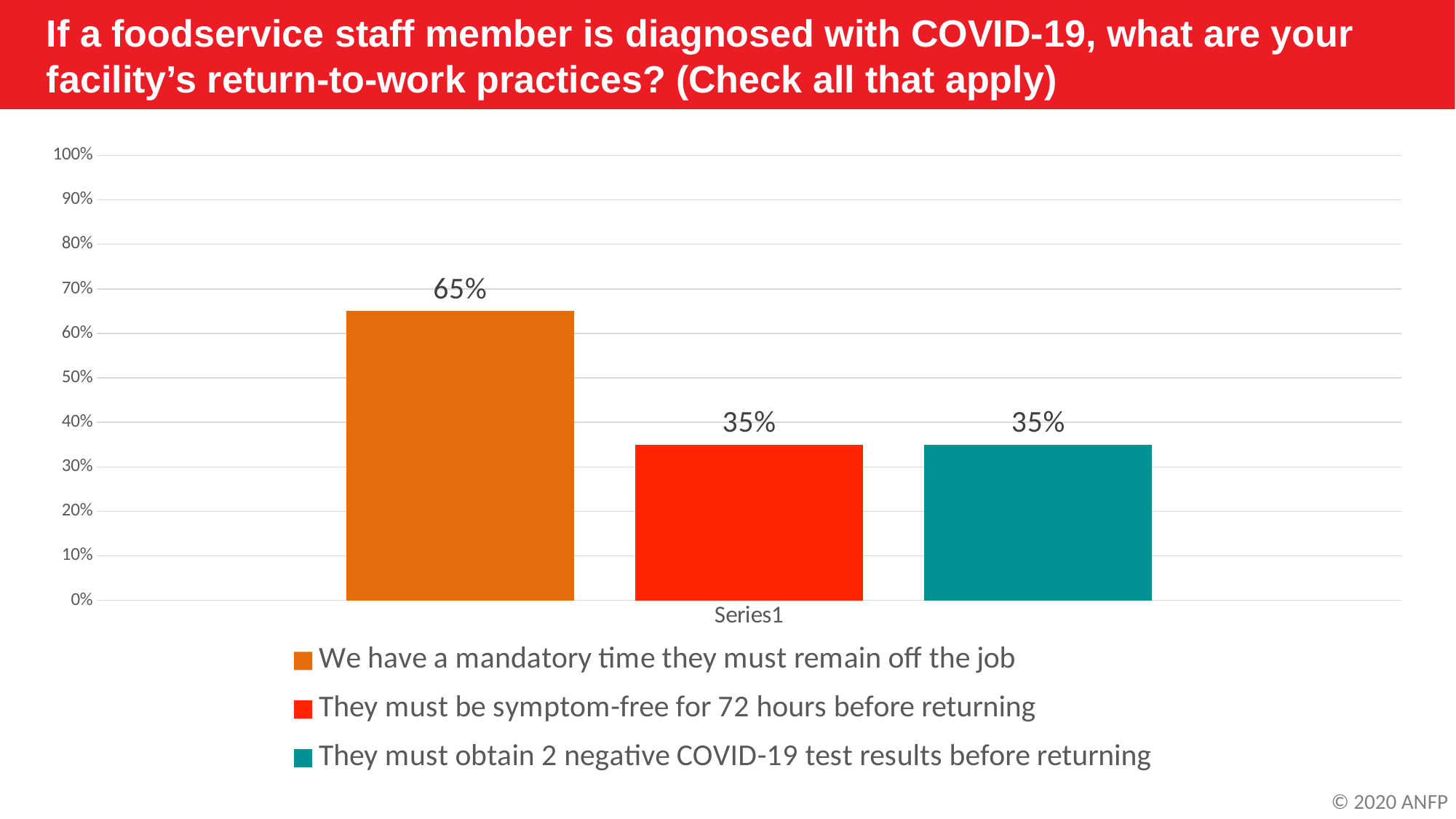
Is the value for being symptom-free for 72 hours greater or less than 40%? less What percentage of respondents said staff must obtain 2 negative COVID-19 test results before returning? 35% Which is larger: the value for a mandatory time off the job or the value for obtaining 2 negative COVID-19 test results? We have a mandatory time they must remain off the job How many entries does the legend list? 3 What is the difference between the percentage for a mandatory time off the job and the percentage for being symptom-free for 72 hours? 30% What kind of chart is shown on the slide? Bar chart What colour is the bar for 'They must obtain 2 negative COVID-19 test results before returning'? Teal What percentage of respondents said staff must be symptom-free for 72 hours before returning? 35% How many bars are plotted on the chart? 3 Which return-to-work practice has the highest percentage? We have a mandatory time they must remain off the job What percentage of respondents said they have a mandatory time staff must remain off the job? 65% Is the value for a mandatory time off the job greater or less than 60%? greater